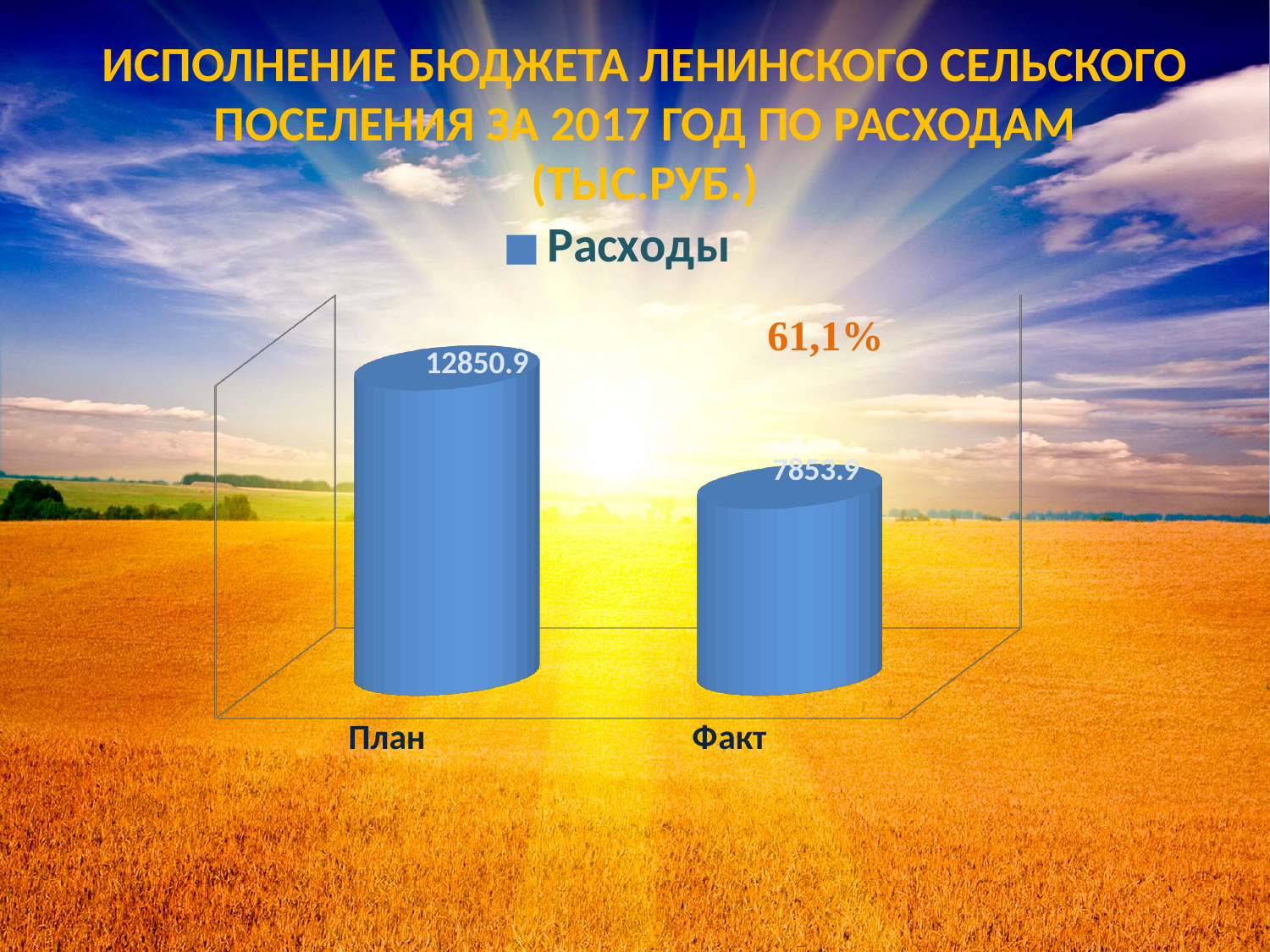
What kind of chart is shown on the slide? bar chart What is the value for План? 12850.9 What is the difference between the values for План and Факт? 4997.0 How many categories are shown on the chart? 2 What series name is shown in the legend? Расходы Do the values rise or fall from План to Факт? fall Which category has the lowest value? Факт Which category has the highest value? План How many series does the legend list? 1 What percentage is printed above the Факт bar? 61,1% What is the value for Факт? 7853.9 Which is larger, the value for План or the value for Факт? План